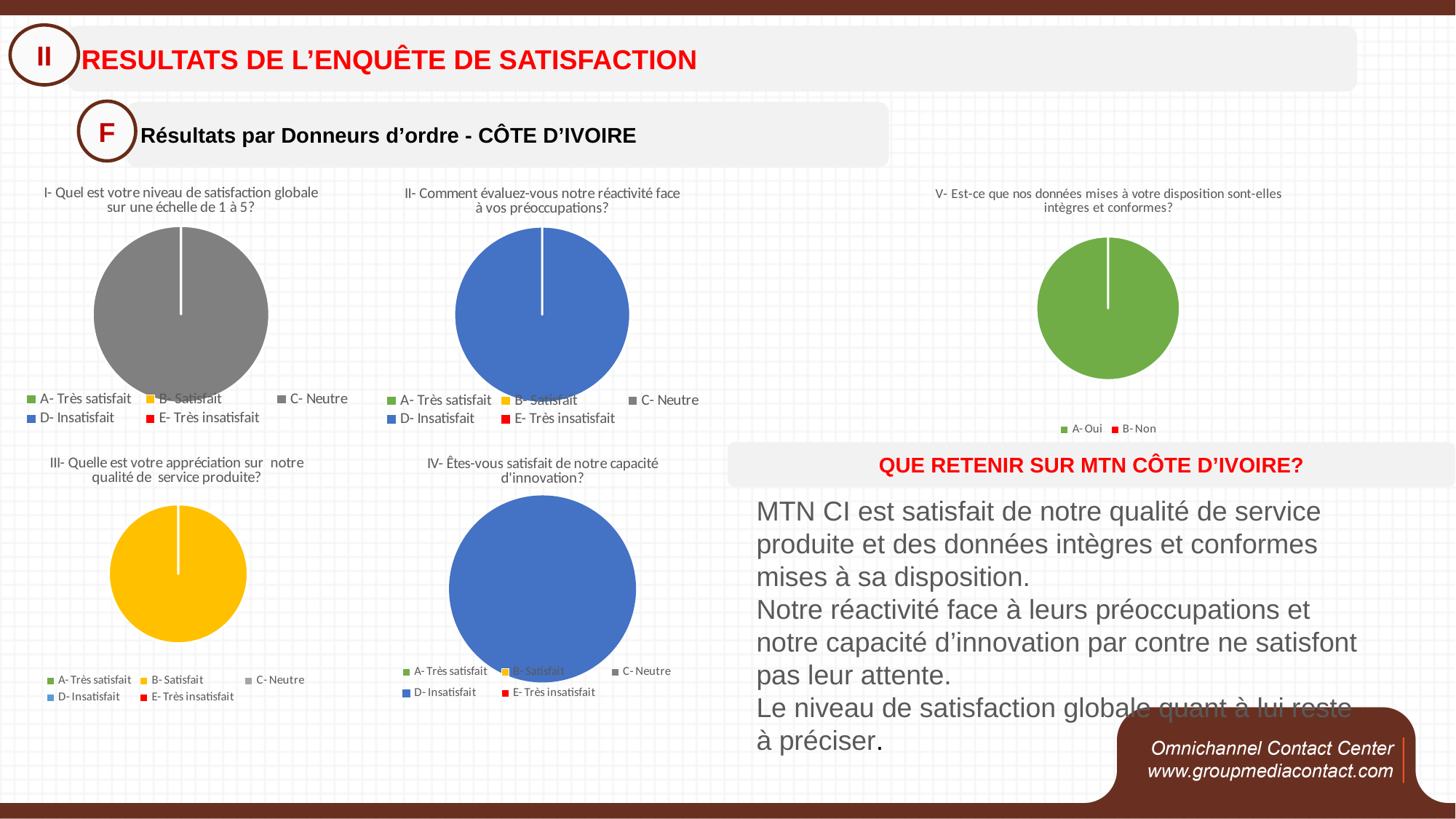
In the chart 'II- Comment évaluez-vous notre réactivité face à vos préoccupations?', what colour is the legend marker for 'E- Très insatisfait'? Red In the chart 'II- Comment évaluez-vous notre réactivité face à vos préoccupations?', which category makes up the entire pie? D- Insatisfait In the chart 'IV- Êtes-vous satisfait de notre capacité d'innovation?', which category makes up the entire pie? D- Insatisfait How many entries does the legend list for the chart 'IV- Êtes-vous satisfait de notre capacité d'innovation?' 5 In the chart 'V- Est-ce que nos données mises à votre disposition sont-elles intègres et conformes?', which category makes up the entire pie? A- Oui What kind of chart is used for 'III- Quelle est votre appréciation sur notre qualité de service produite?' Pie chart What kind of chart is used for 'I- Quel est votre niveau de satisfaction globale sur une échelle de 1 à 5?' Pie chart How many entries does the legend list for the chart 'I- Quel est votre niveau de satisfaction globale sur une échelle de 1 à 5?' 5 How many pie charts are shown on the slide? 5 How many entries does the legend list for the chart 'V- Est-ce que nos données mises à votre disposition sont-elles intègres et conformes?' 2